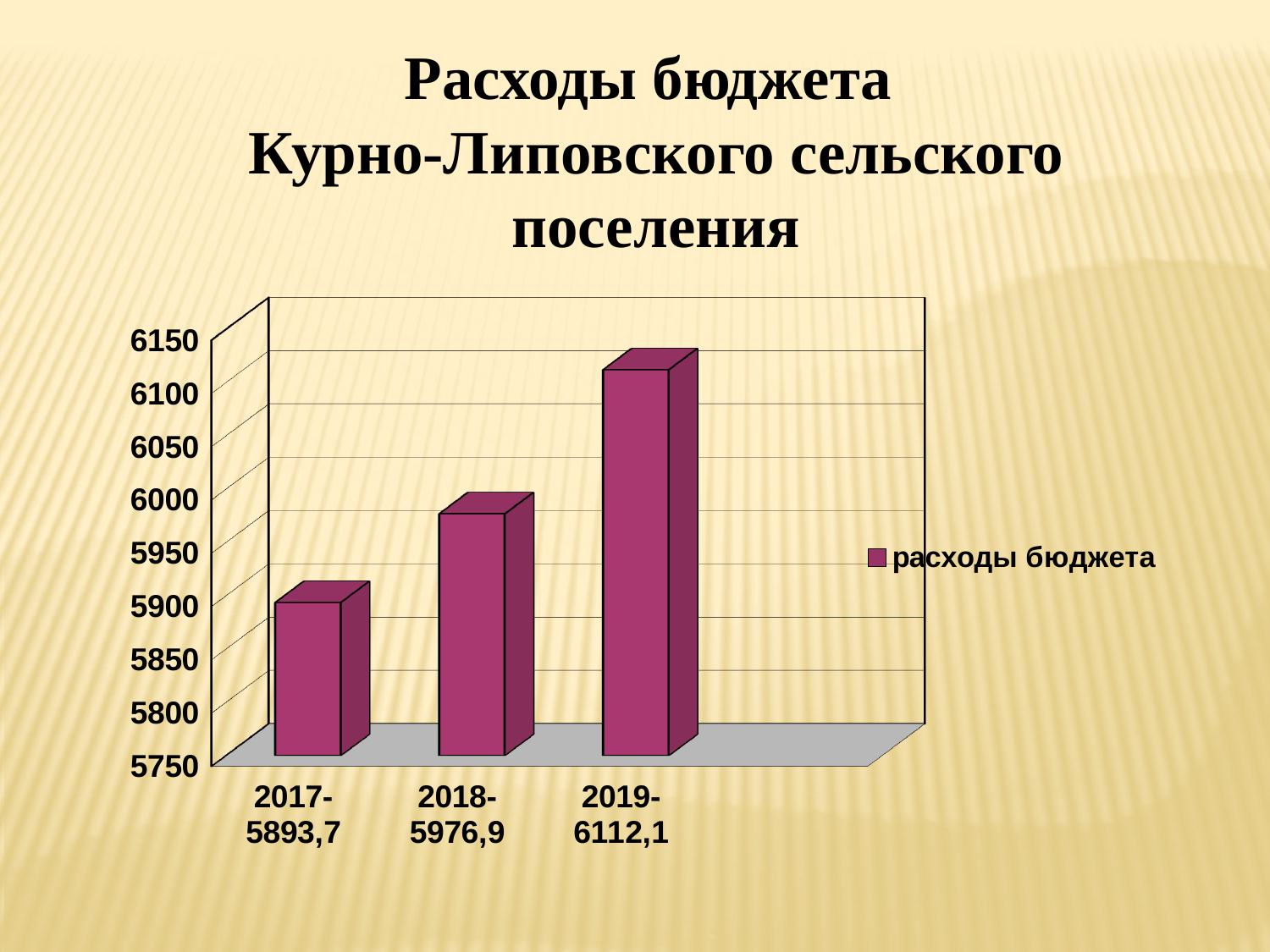
What kind of chart is shown on the slide? bar chart What is the budget expenditure value shown for 2017? 5893,7 What is the difference between the 2018 and 2017 budget expenditure values? 83,2 Which year has the lowest budget expenditure? 2017 Is the value for 2019 greater or less than 6100? greater What is the difference between the 2019 and 2018 budget expenditure values? 135,2 How many years are shown on the chart? 3 What is the budget expenditure value shown for 2019? 6112,1 What is the budget expenditure value shown for 2018? 5976,9 Do the budget expenditure values rise or fall from 2017 to 2019? rise Which year has the highest budget expenditure? 2019 Which is larger, the budget expenditure for 2018 or for 2017? 2018